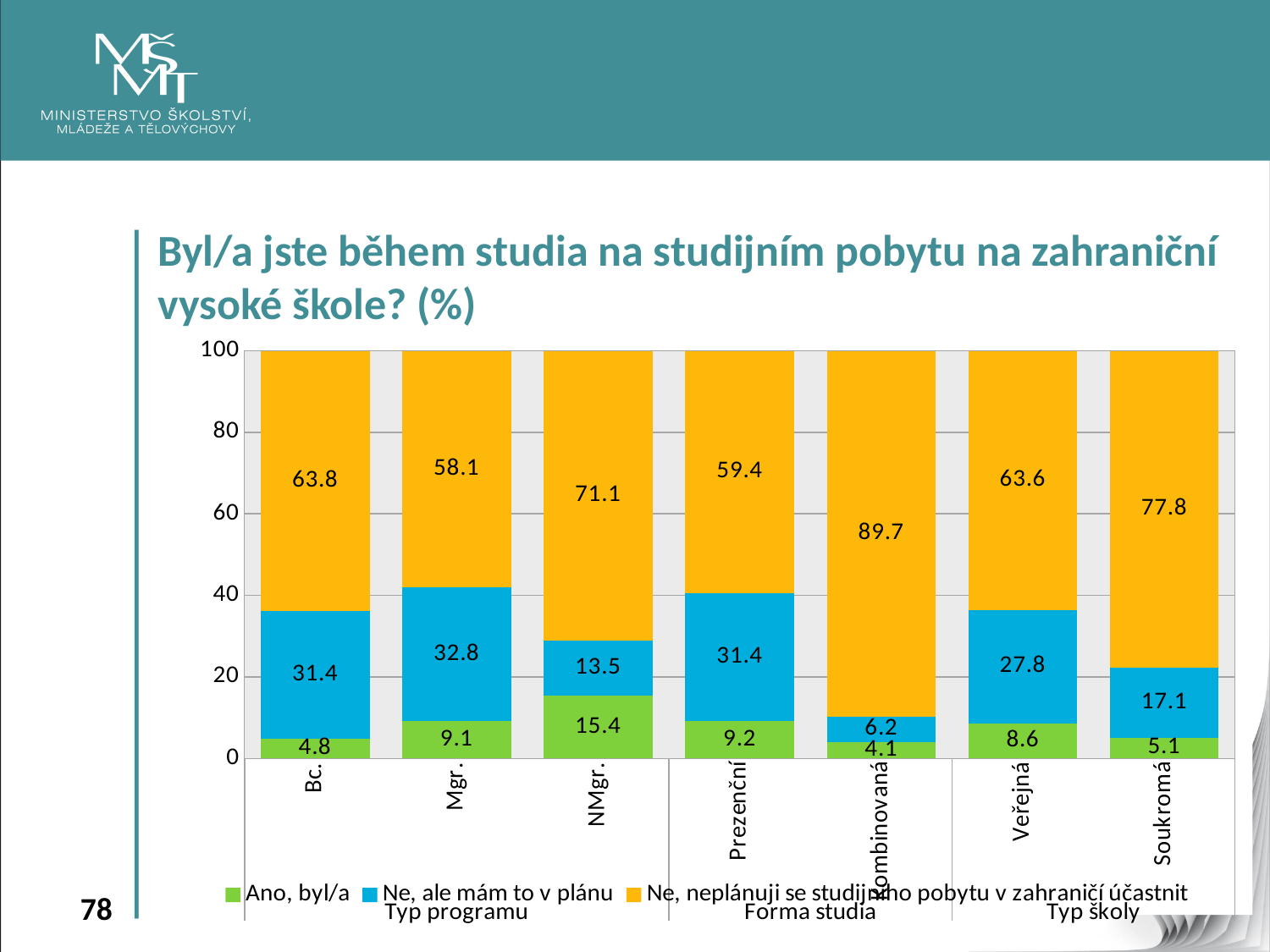
What is the difference between the "Ne, neplánuji se studijního pobytu v zahraničí účastnit" values for Soukromá and Veřejná? 14.2 How many series does the legend list? 3 What is the value of "Ano, byl/a" for NMgr.? 15.4 What is the value of "Ne, ale mám to v plánu" for Soukromá? 17.1 Which category has the lowest value for "Ne, ale mám to v plánu"? Kombinovaná What kind of chart is shown on the slide? Stacked bar chart What is the total of the stacked bar for Bc.? 100 Which colour represents "Ano, byl/a" in the chart? Green What is the value of "Ne, neplánuji se studijního pobytu v zahraničí účastnit" for Kombinovaná? 89.7 Which is larger: the "Ne, ale mám to v plánu" value for Mgr. or for Veřejná? Mgr. Which category has the highest value for "Ano, byl/a"? NMgr. How many categories are shown on the x axis? 7